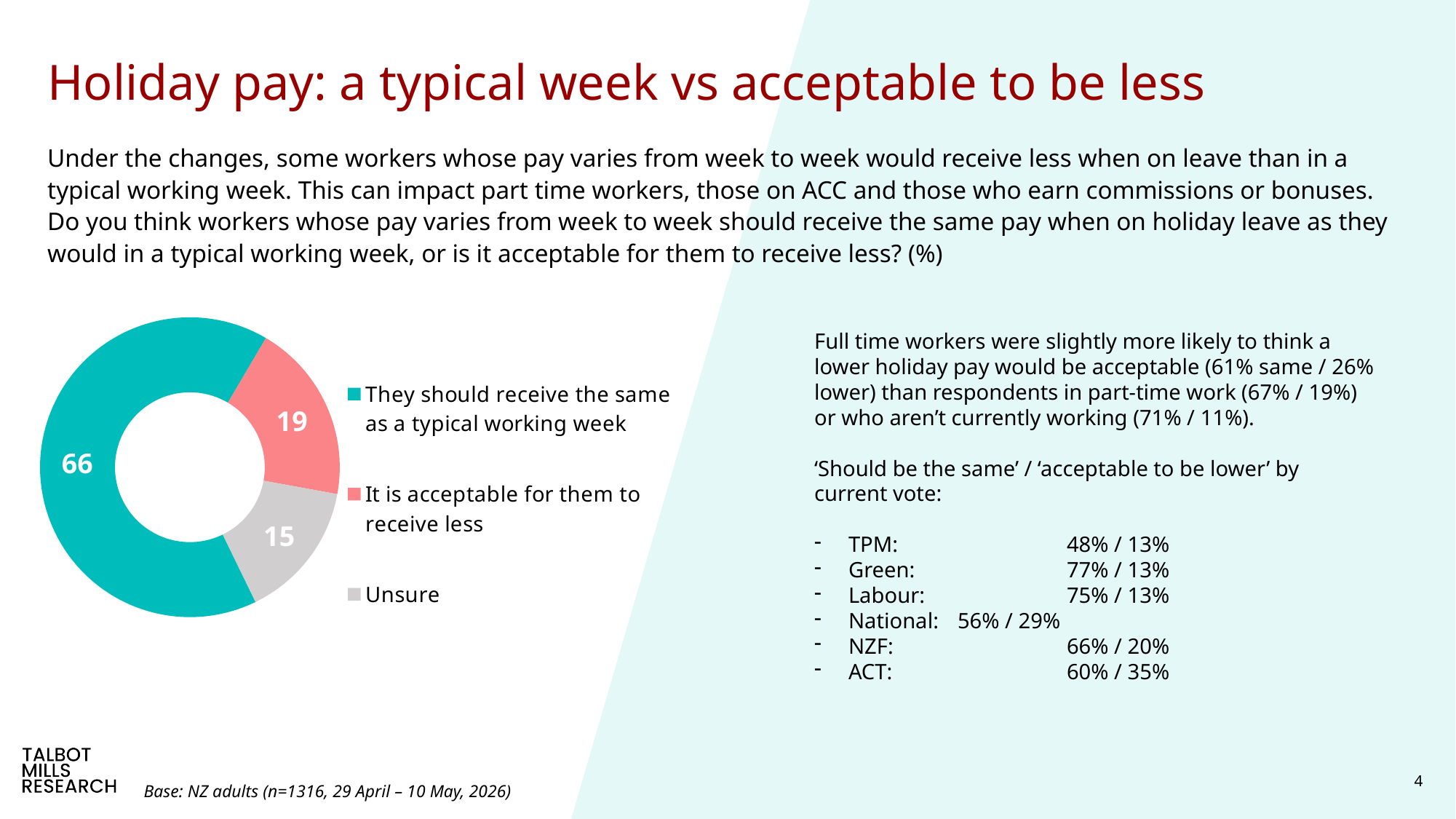
What is the difference between the share saying they should receive the same and the share saying it is acceptable to receive less? 47 Which response has the smallest share of the chart? Unsure How many categories are shown in the chart? 3 Which is larger: the share saying it is acceptable to receive less, or the share that is unsure? It is acceptable for them to receive less What colour represents the 'Unsure' category in the chart? Grey What type of chart is shown on the slide? Doughnut (pie) chart Which response has the largest share of the chart? They should receive the same as a typical working week What percentage of respondents said workers should receive the same as a typical working week? 66 What percentage of respondents said it is acceptable for them to receive less? 19 What colour represents 'They should receive the same as a typical working week' in the chart? Teal What percentage of respondents were unsure? 15 What is the total of the three values shown in the chart? 100